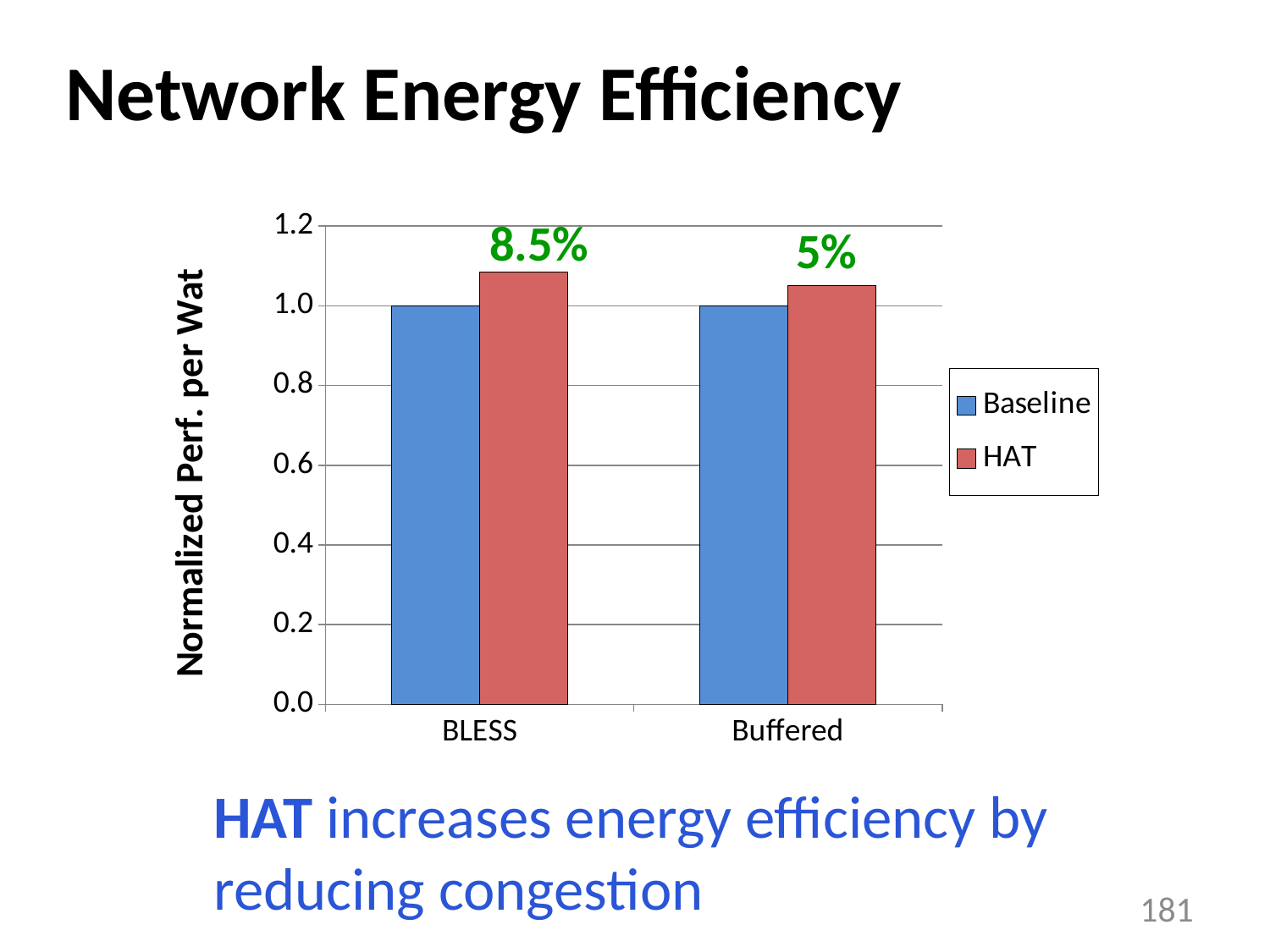
Which category has the higher HAT bar, BLESS or Buffered? BLESS What is the Baseline value for Buffered? 1.0 How many series does the chart's legend list? 2 What kind of chart is shown on the slide? bar chart What is the Baseline value for BLESS? 1.0 Is the HAT value for Buffered greater or less than 1.2? less Is the HAT value for BLESS greater or less than 1.0? greater How many categories are shown on the x axis of the chart? 2 For BLESS, which is larger: the Baseline bar or the HAT bar? HAT What percentage improvement is annotated above the Buffered bars? 5% What percentage improvement is annotated above the BLESS bars? 8.5% For Buffered, which is larger: the Baseline bar or the HAT bar? HAT